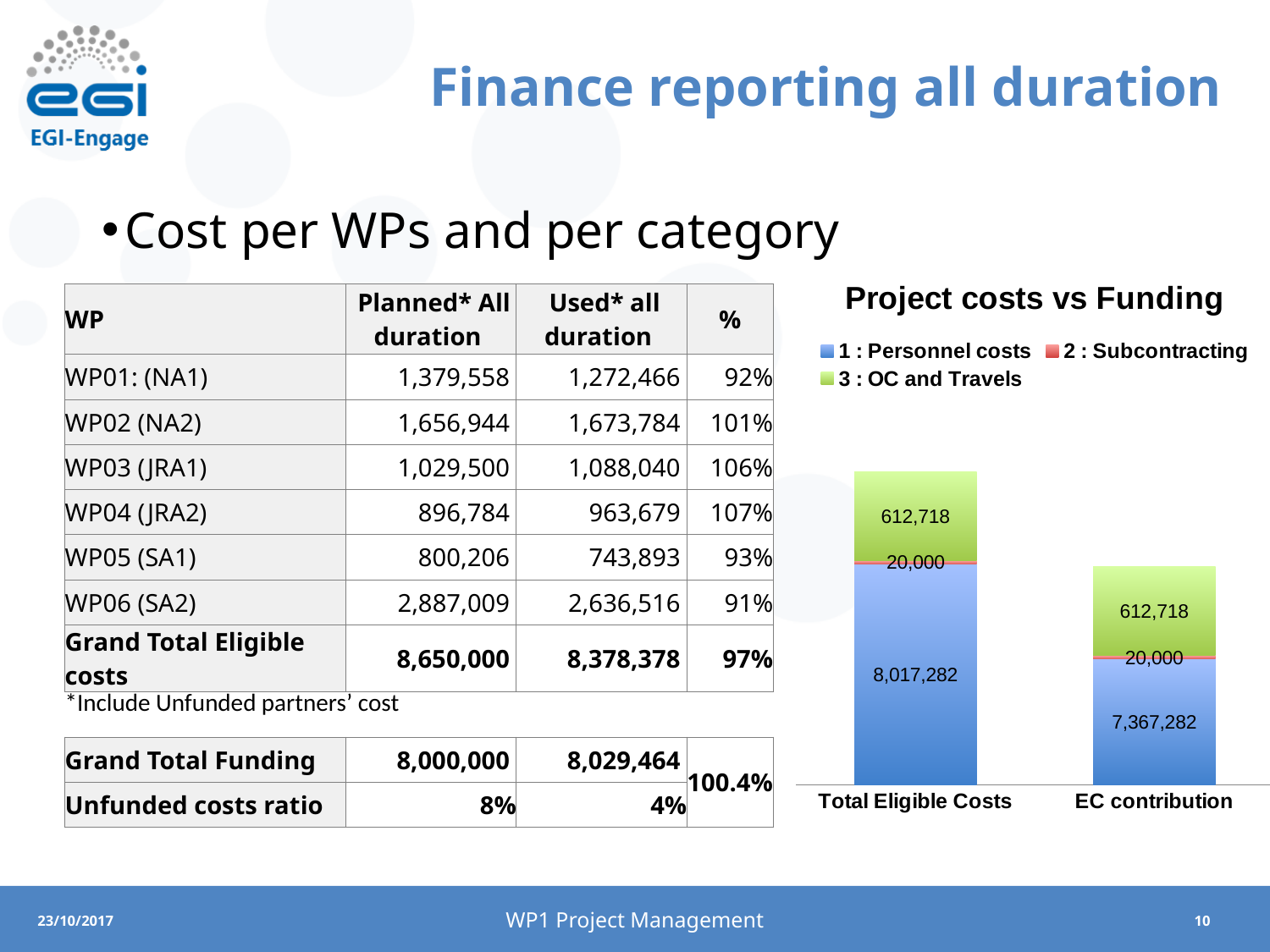
In the 'Project costs vs Funding' chart, what is the difference in Personnel costs between Total Eligible Costs and EC contribution? 650,000 In the 'Project costs vs Funding' chart, what is the total of the EC contribution stacked bar? 8,000,000 In the 'Project costs vs Funding' chart, what is the value of Subcontracting for Total Eligible Costs? 20,000 How many categories are shown on the x axis of the 'Project costs vs Funding' chart? 2 In the 'Project costs vs Funding' chart, which series is shown in green? 3 : OC and Travels In the 'Project costs vs Funding' chart, what is the value of Personnel costs for Total Eligible Costs? 8,017,282 What type of chart is 'Project costs vs Funding'? stacked bar chart In the 'Project costs vs Funding' chart, which category has the larger Personnel costs value, Total Eligible Costs or EC contribution? Total Eligible Costs How many series does the legend of the 'Project costs vs Funding' chart list? 3 In the 'Project costs vs Funding' chart, what is the value of OC and Travels for EC contribution? 612,718 In the 'Project costs vs Funding' chart, what is the total of the Total Eligible Costs stacked bar? 8,650,000 In the 'Project costs vs Funding' chart, what is the value of Personnel costs for EC contribution? 7,367,282